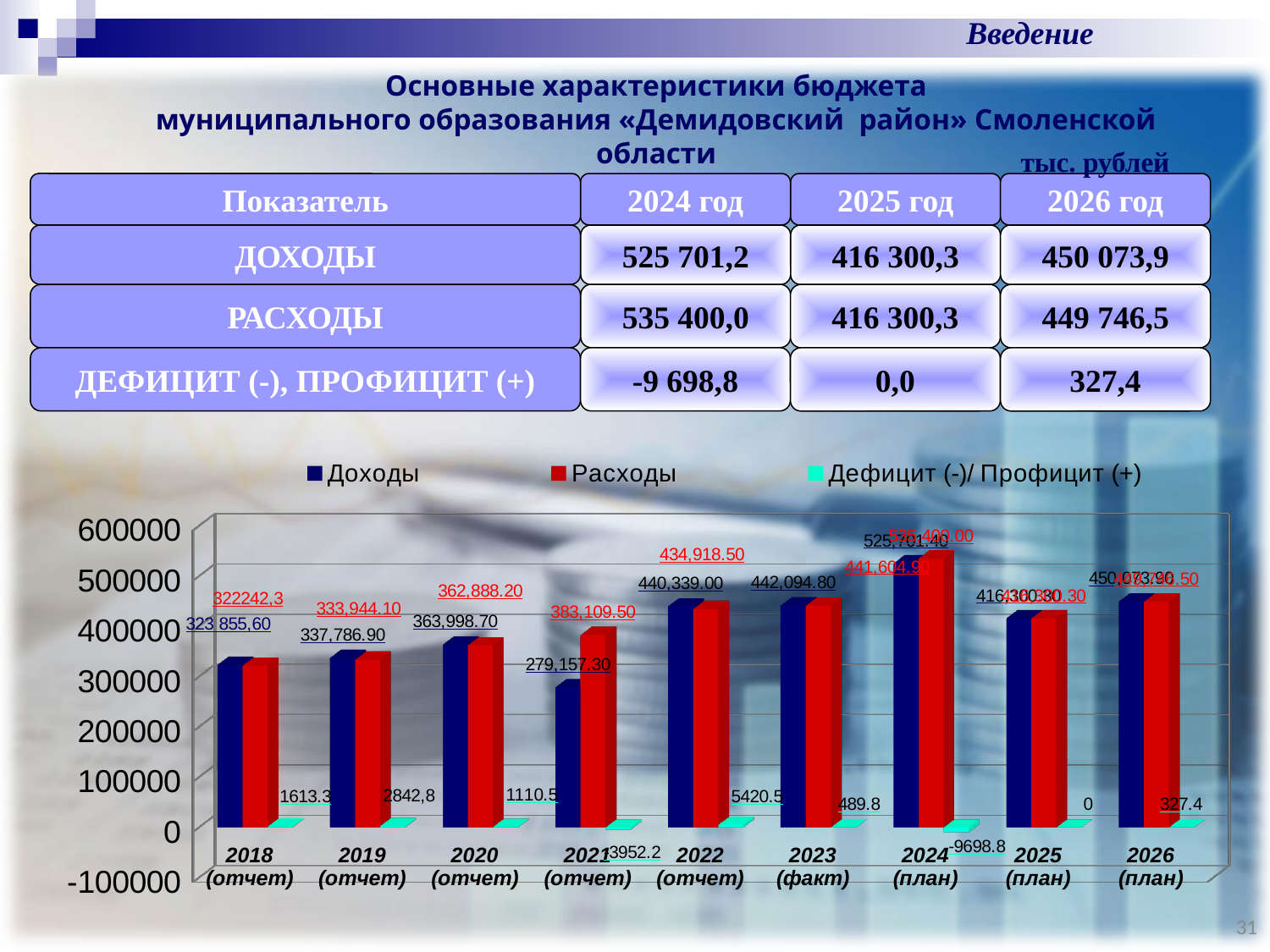
In which year is the Доходы bar the lowest? 2021 (отчет) How many year categories are shown along the x axis of the chart? 9 In which year is the Расходы bar the highest? 2024 (план) How many series does the chart legend list? 3 What kind of chart is shown on the slide? bar chart What is the difference between Доходы for 2023 (факт) and Доходы for 2022 (отчет)? 1,755.80 For 2021 (отчет), which is larger: Доходы or Расходы? Расходы What is the value of Расходы for 2021 (отчет) in the chart? 383,109.50 What is the value of Доходы for 2021 (отчет) in the chart? 279,157.30 What is the value of Дефицит (-)/ Профицит (+) for 2022 (отчет) in the chart? 5420.5 What is the value of Доходы for 2022 (отчет) in the chart? 440,339.00 Is the value of Доходы for 2018 (отчет) greater or less than 400000? less